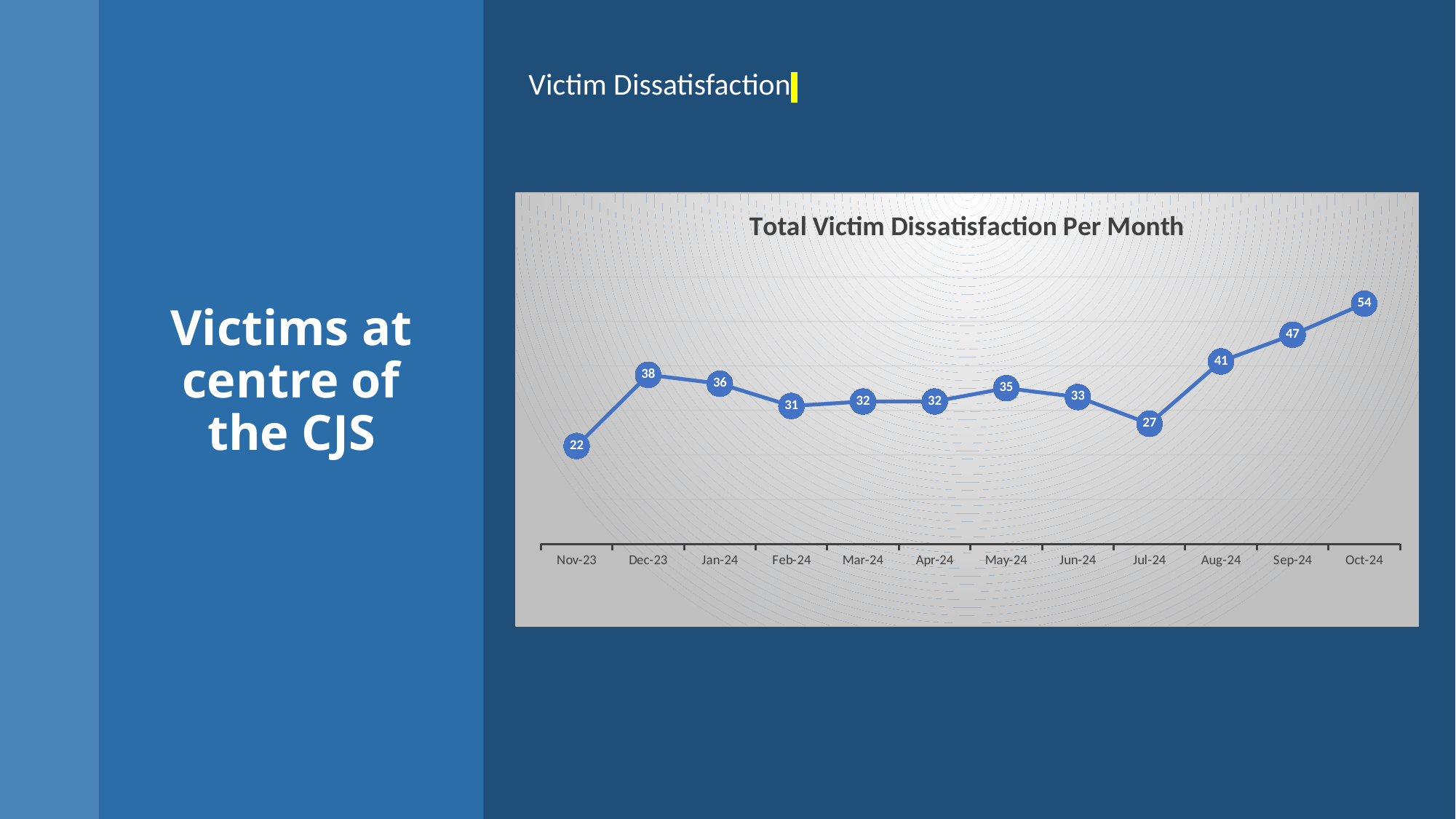
Which month has the lowest value? Nov-23 How many months are plotted on the chart? 12 Which month has the highest value? Oct-24 What is the value for Jul-24? 27 Which is larger, the value for May-24 or the value for Jun-24? May-24 What is the title of the chart? Total Victim Dissatisfaction Per Month Do the values rise or fall from Jul-24 to Oct-24? Rise What is the difference between the values for Dec-23 and Nov-23? 16 What kind of chart is shown? Line chart What is the value for Oct-24? 54 What is the difference between the values for Oct-24 and Sep-24? 7 What is the value for Nov-23? 22